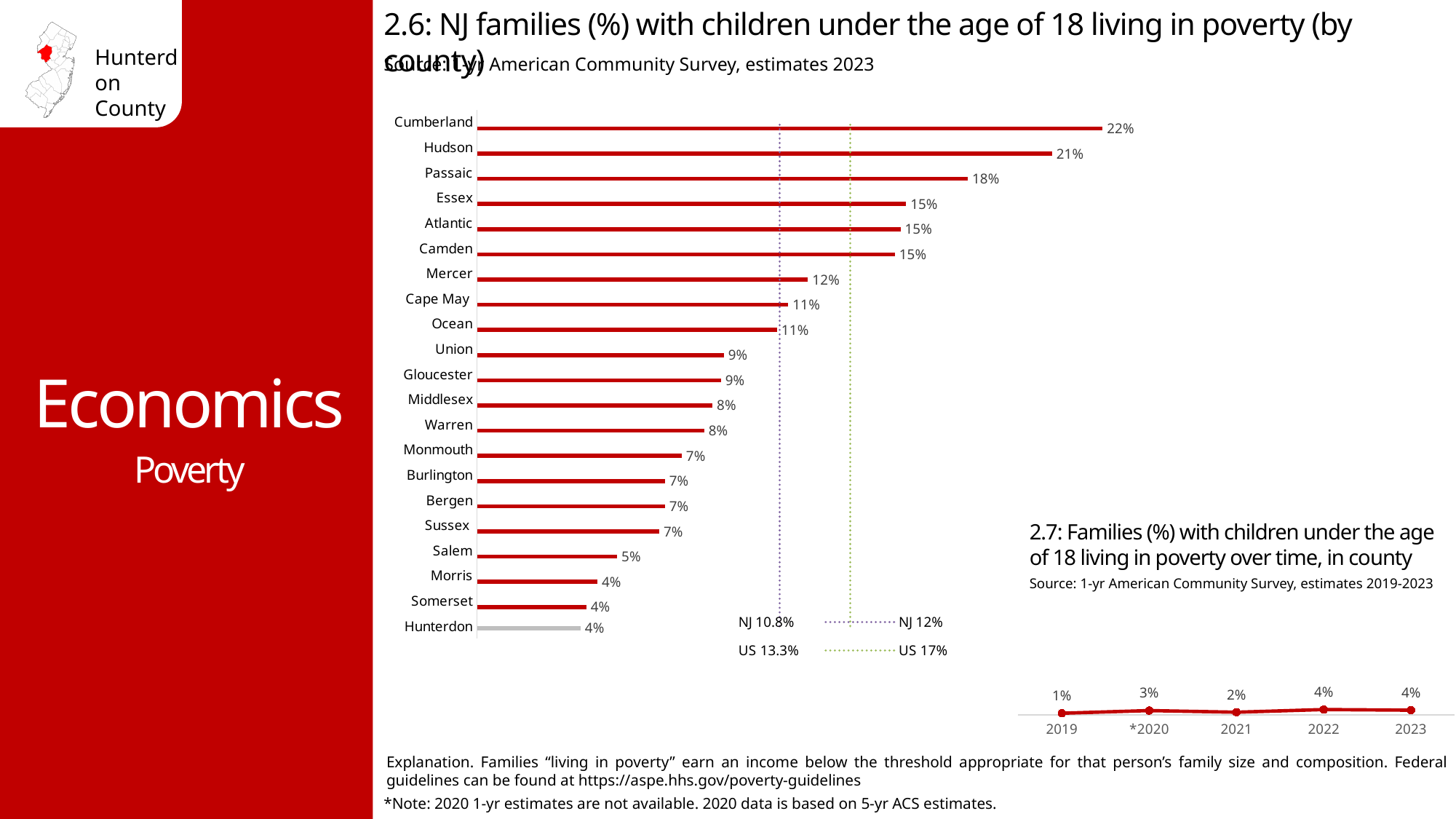
In chart 2.6, what is the difference between the values for Hudson and Passaic? 3% In chart 2.6, what is the value for Salem? 5% In chart 2.7, what is the value for 2022? 4% In chart 2.6, which county has the highest value? Cumberland In chart 2.6, what is the value for Hunterdon? 4% In chart 2.6, how many counties are listed? 21 In chart 2.6, which is larger, the value for Mercer or the value for Union? Mercer In chart 2.7, how many years are plotted? 5 What kind of chart is chart 2.6? Bar chart In chart 2.6, what is the value for Cumberland? 22% In chart 2.7, what is the value for 2019? 1%